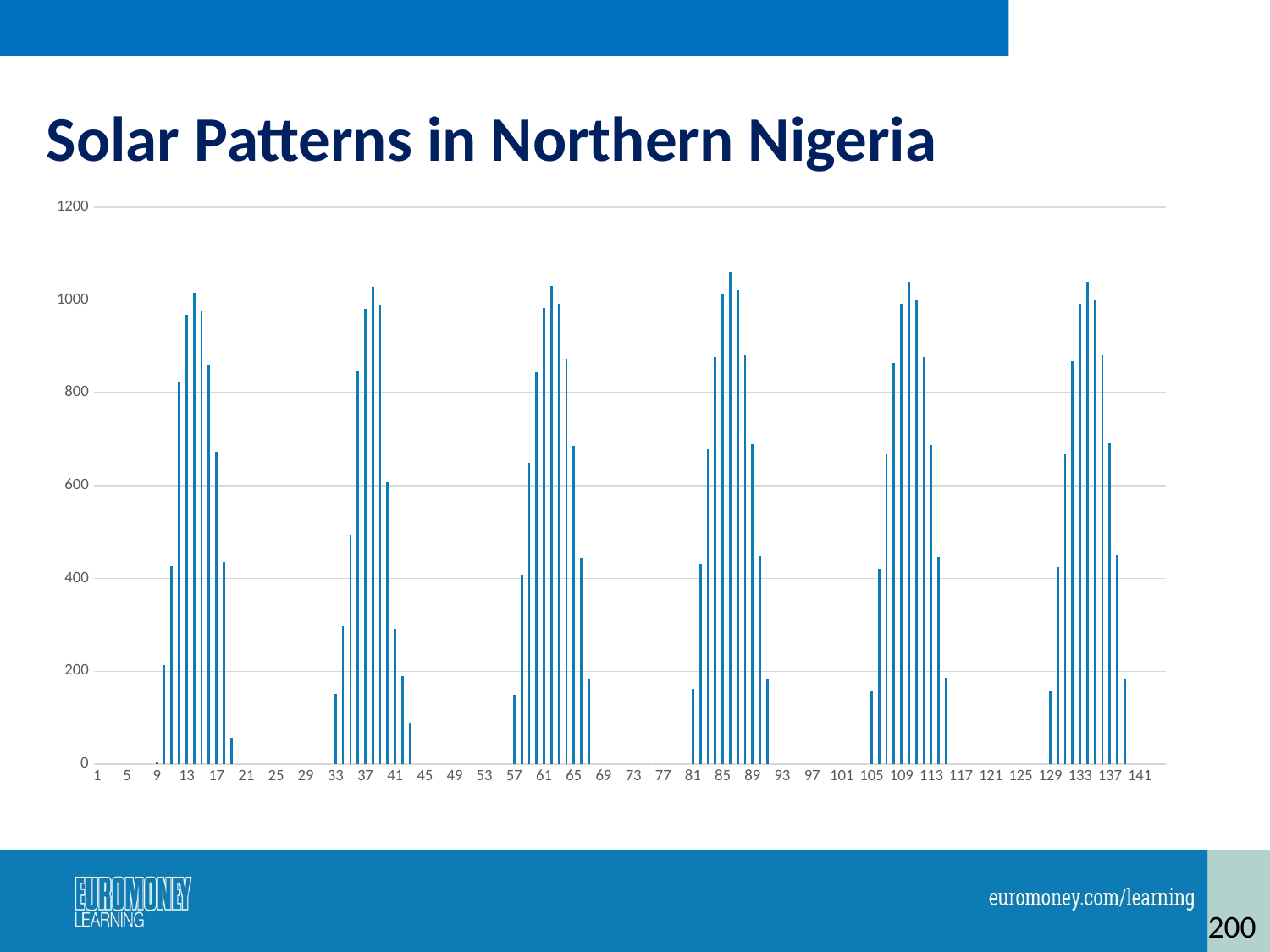
What kind of chart is shown on the slide? bar chart Is the value at category 21 greater or less than 200? less Is the tallest bar on the chart greater or less than 1000? greater What is the title of the chart? Solar Patterns in Northern Nigeria How many separate clusters (peaks) of bars appear across the x axis? 6 What is the highest value shown on the y axis? 1200 Is the value at category 100 greater or less than 200? less